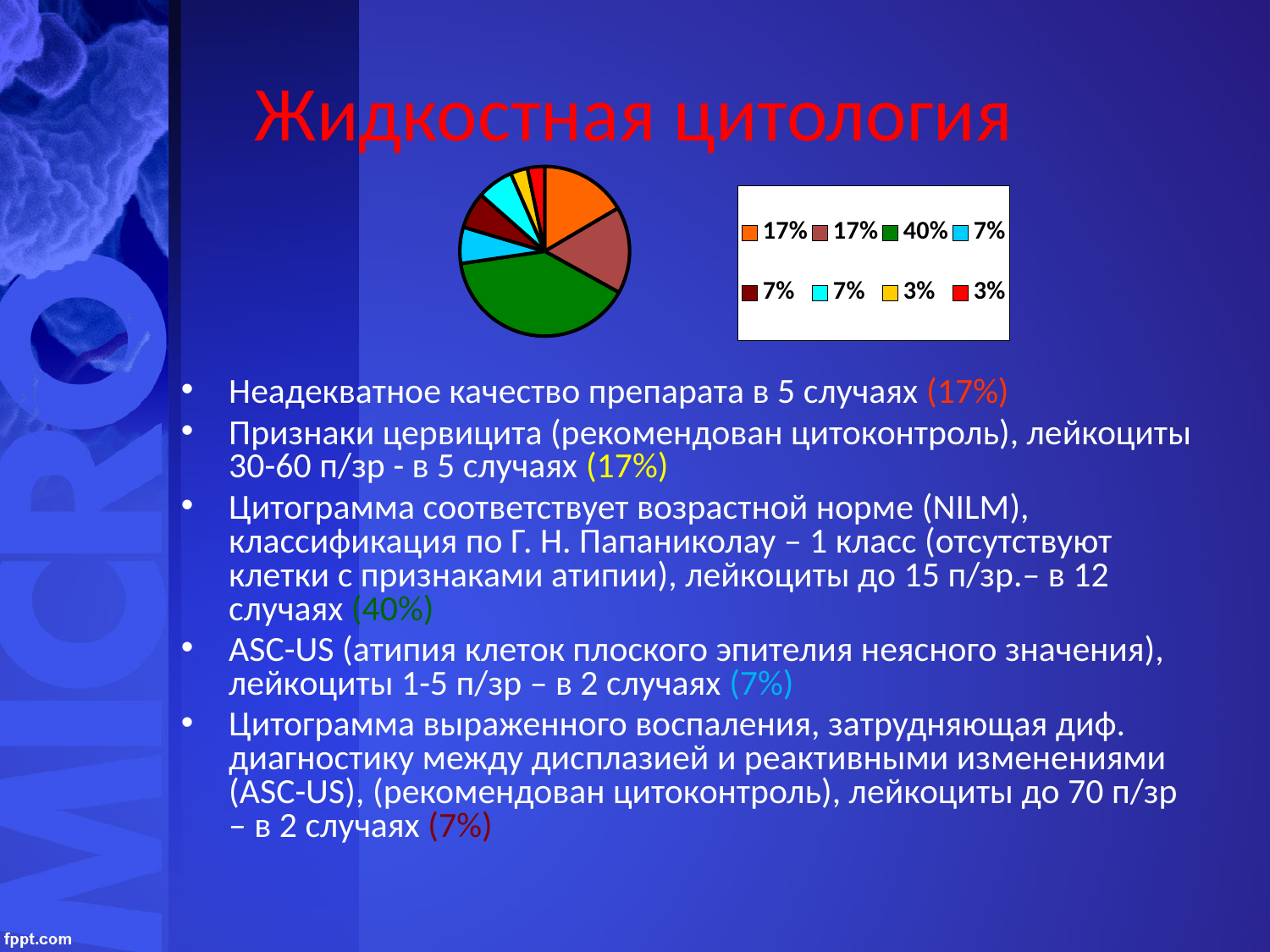
What kind of chart is shown on the slide? pie chart What share does the green slice of the pie chart represent? 40% What is the smallest share shown in the pie chart legend? 3% What is the title of the slide containing the pie chart? Жидкостная цитология What is the combined share of the two 17% slices? 34% What is the difference between the largest slice (40%) and one of the 17% slices? 23% How many slices does the pie chart have? 8 What is the largest share shown in the pie chart legend? 40% How many slices in the pie chart are labelled 3%? 2 How many slices in the pie chart are labelled 7%? 3 Which slice is larger, the orange one or the yellow one? orange What share does the orange slice of the pie chart represent? 17%